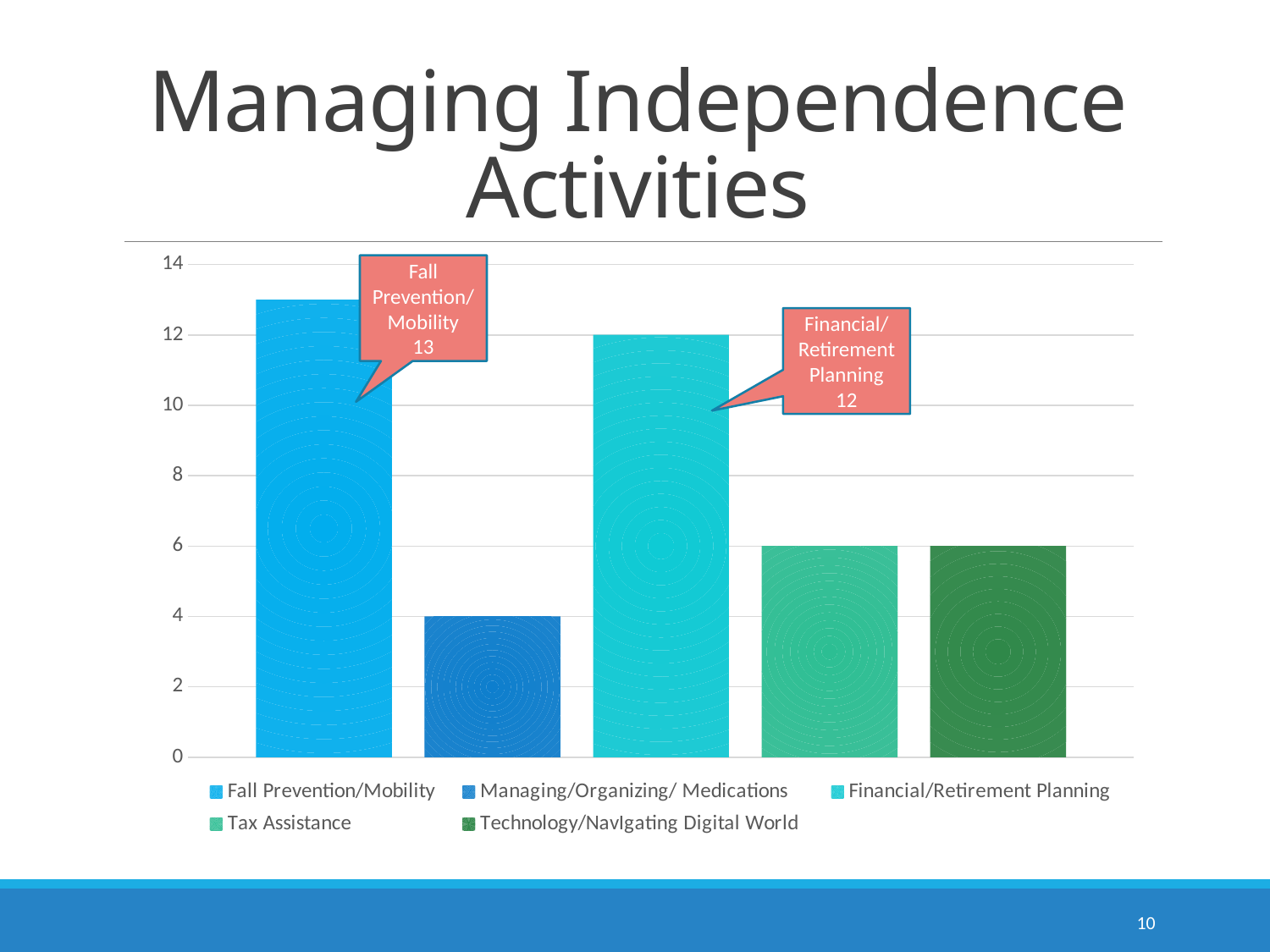
What is the difference between the values for Fall Prevention/Mobility and Financial/Retirement Planning? 1 What kind of chart is shown on the slide? bar chart What is the value for Fall Prevention/Mobility? 13 Which activity has the lowest value? Managing/Organizing/ Medications How many entries does the legend list? 5 Which is larger, the value for Fall Prevention/Mobility or the value for Financial/Retirement Planning? Fall Prevention/Mobility What is the difference between the values for Financial/Retirement Planning and Tax Assistance? 6 How many bars are plotted in the chart? 5 What is the value for Financial/Retirement Planning? 12 Which activity has the highest value? Fall Prevention/Mobility What is the value for Tax Assistance? 6 What is the value for Managing/Organizing/ Medications? 4